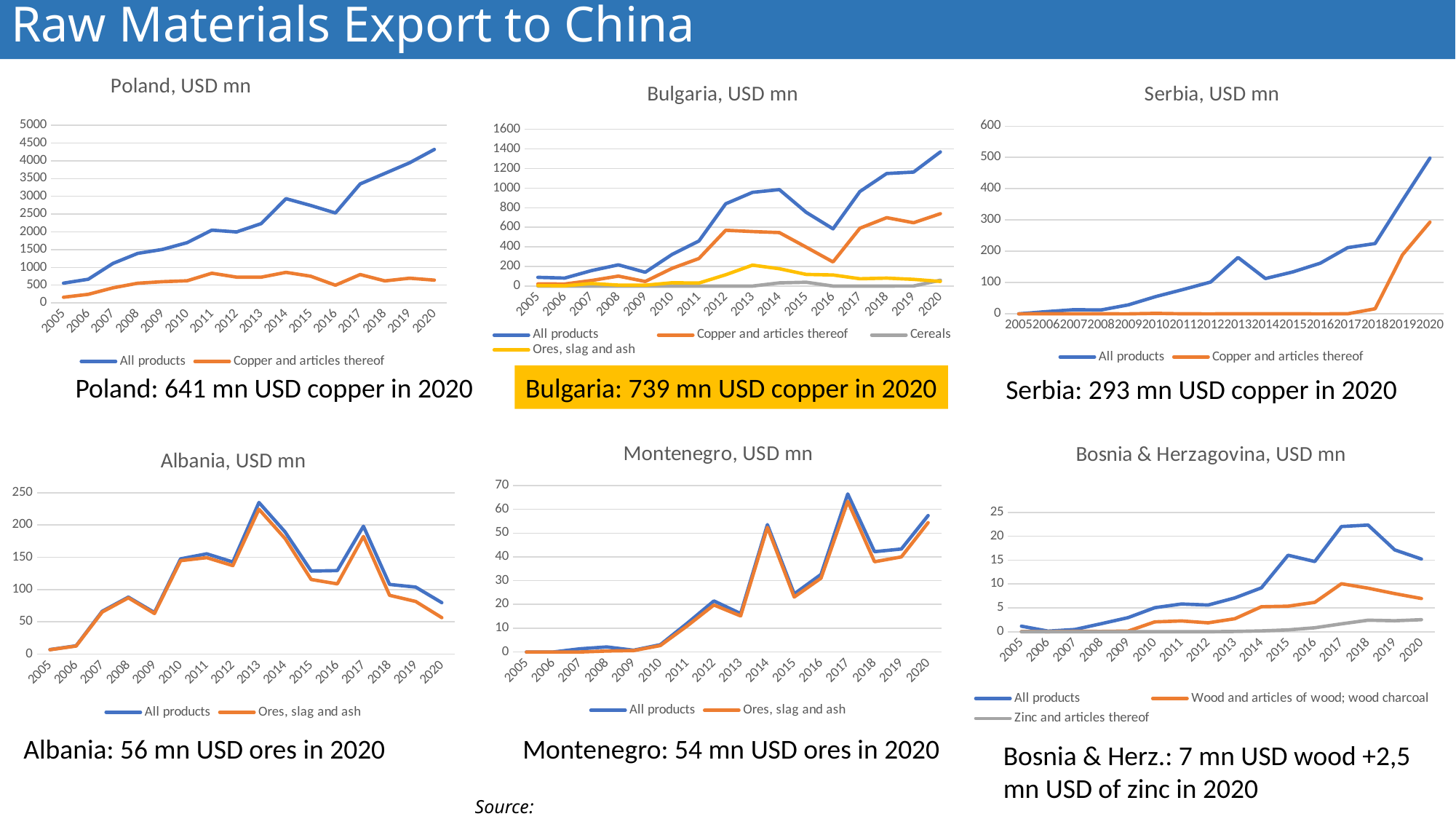
In the Montenegro, USD mn chart, in which year does the All products line reach its highest value? 2017 In the Poland, USD mn chart, is the value for All products in 2020 greater or less than 4000? greater How many years are shown on the x axis of the Serbia, USD mn chart? 16 According to the captions, which was larger in 2020: Bulgaria's copper export or Poland's copper export? Bulgaria's copper export According to the caption under the Poland chart, what was Poland's copper export to China in 2020? 641 mn USD What kind of chart is the Poland, USD mn chart? Line chart In the Albania, USD mn chart, in which year does the All products line reach its highest value? 2013 According to the caption under the Serbia chart, what was Serbia's copper export to China in 2020? 293 mn USD Using the captions, what is the difference between Albania's and Montenegro's ores exports in 2020? 2 mn USD How many series does the legend of the Bosnia & Herzagovina, USD mn chart list? 3 Using the captions, what is the difference between Bulgaria's and Poland's copper exports in 2020? 98 mn USD How many series does the legend of the Bulgaria, USD mn chart list? 4